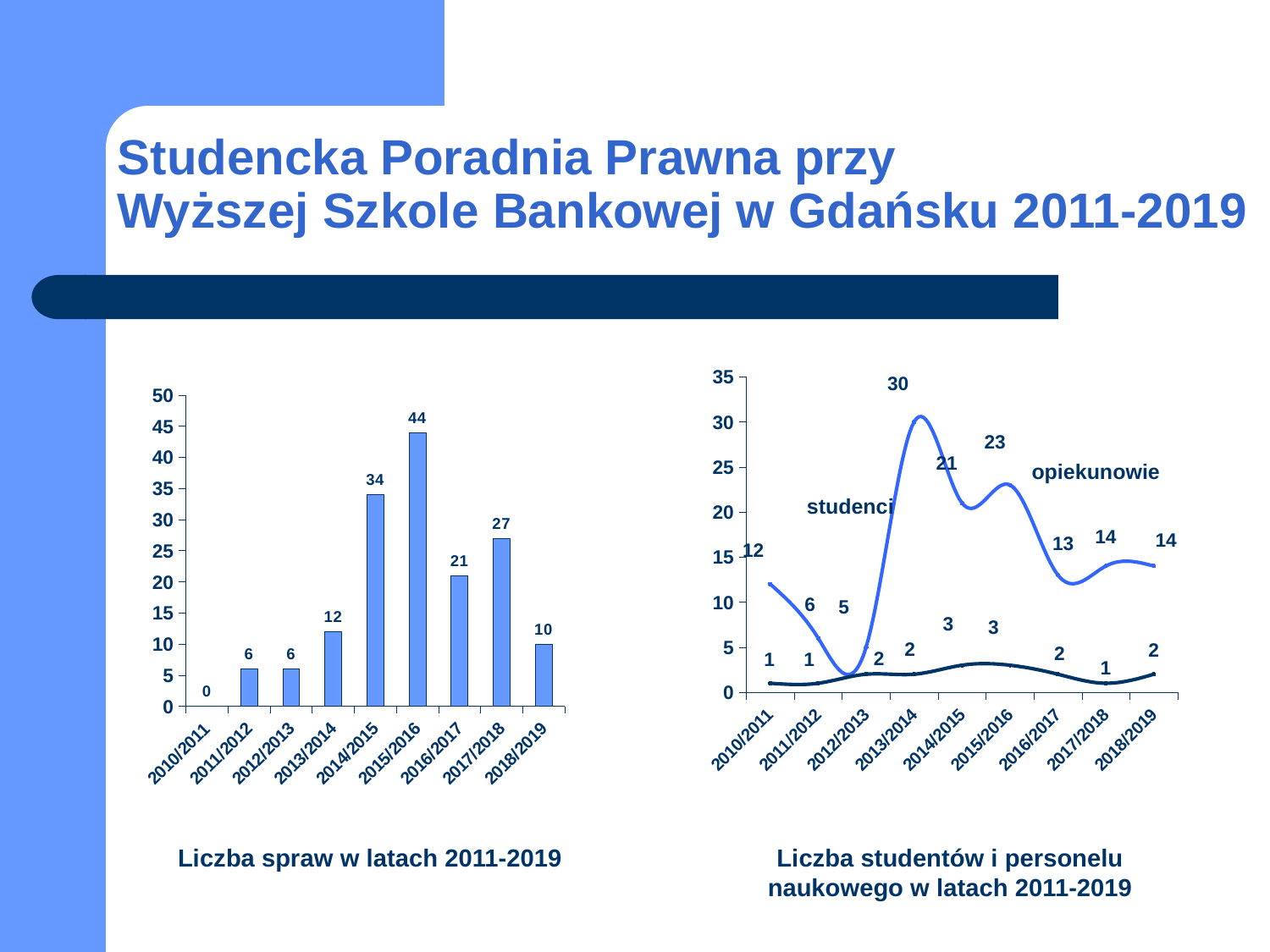
In the left chart (Liczba spraw w latach 2011-2019), which year has the lowest value? 2010/2011 In the left chart (Liczba spraw w latach 2011-2019), what is the difference between the values for 2015/2016 and 2014/2015? 10 In the left chart (Liczba spraw w latach 2011-2019), which is larger, the value for 2016/2017 or 2017/2018? 2017/2018 In the right chart (Liczba studentów i personelu naukowego w latach 2011-2019), what is the value for studenci in 2013/2014? 30 In the left chart (Liczba spraw w latach 2011-2019), which year has the highest number of cases? 2015/2016 In the left chart (Liczba spraw w latach 2011-2019), how many years are shown on the x axis? 9 In the right chart (Liczba studentów i personelu naukowego w latach 2011-2019), what is the difference between studenci and opiekunowie in 2015/2016? 20 In the left chart (Liczba spraw w latach 2011-2019), what is the value for 2015/2016? 44 In the right chart (Liczba studentów i personelu naukowego w latach 2011-2019), what is the value for opiekunowie in 2017/2018? 1 What kind of chart is the right chart (Liczba studentów i personelu naukowego w latach 2011-2019)? line chart What kind of chart is the left chart (Liczba spraw w latach 2011-2019)? bar chart In the right chart (Liczba studentów i personelu naukowego w latach 2011-2019), how many series are plotted? 2